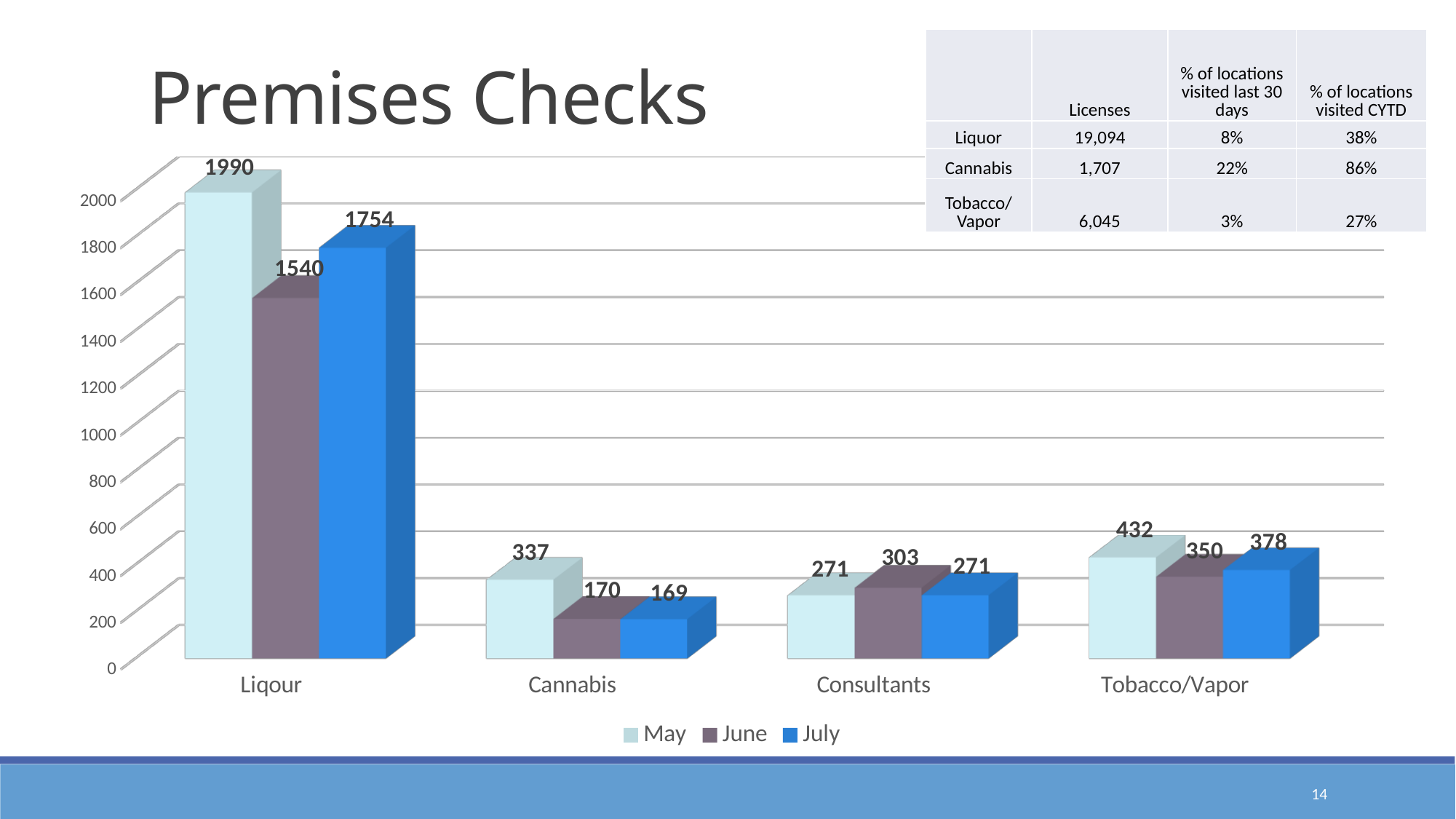
Which is larger for Tobacco/Vapor, the May value or the June value? May What kind of chart is shown on the slide? Bar chart What is the difference between the May and June values for Liqour? 450 What is the title of the slide containing the chart? Premises Checks What is the value for Consultants in June? 303 Which category has the highest value in May? Liqour Which category has the lowest value in July? Cannabis How many categories are shown on the x axis? 4 How many series does the legend list? 3 What is the value for Liqour in May? 1990 What is the value for Tobacco/Vapor in July? 378 What is the value for Cannabis in July? 169